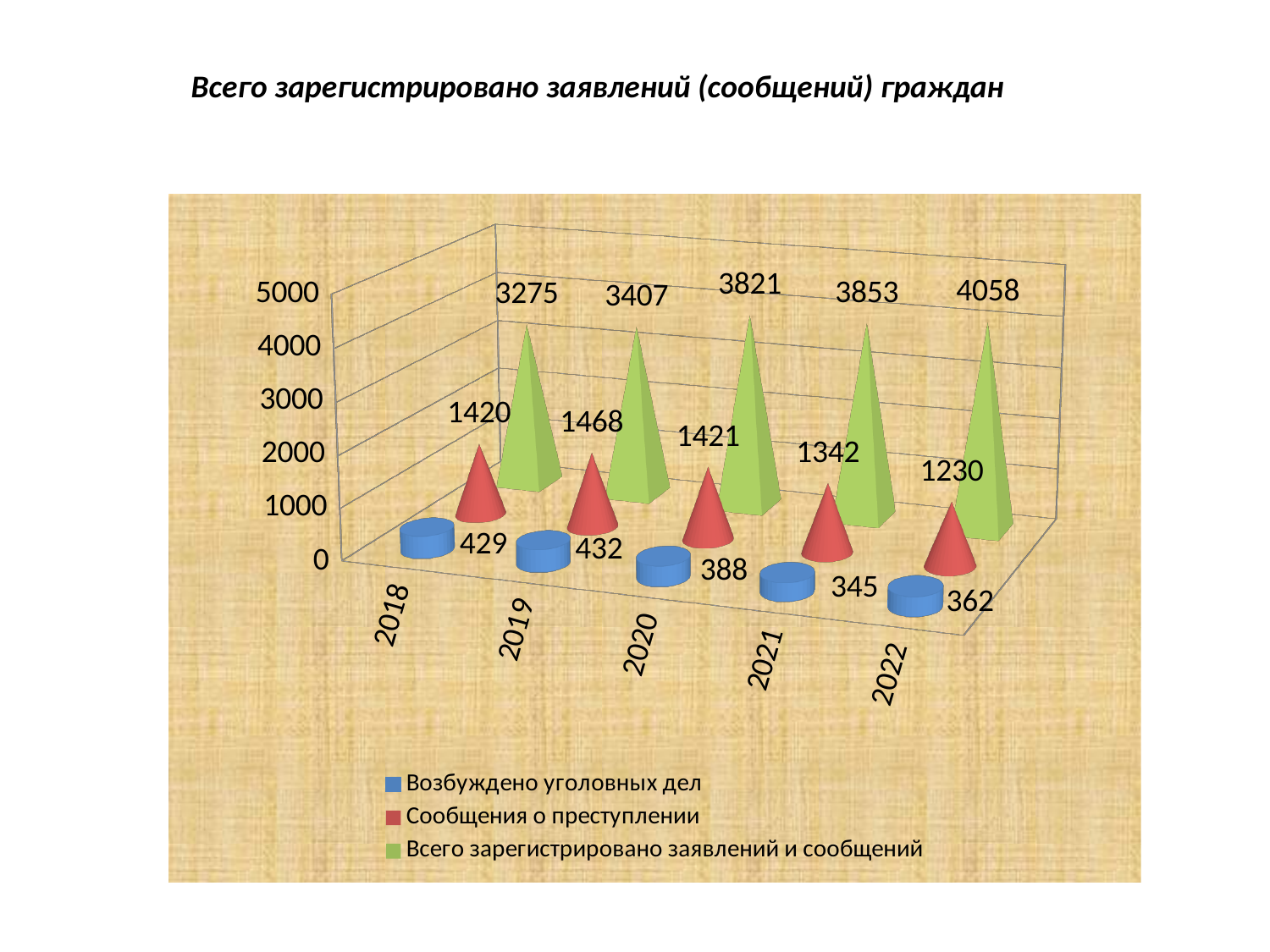
What is the value for 'Всего зарегистрировано заявлений и сообщений' in 2022? 4058 Does 'Всего зарегистрировано заявлений и сообщений' rise or fall from 2018 to 2022? rise What kind of chart is shown on the slide? bar chart In which year is 'Возбуждено уголовных дел' lowest? 2021 What is the difference between 'Всего зарегистрировано заявлений и сообщений' in 2022 and in 2018? 783 Is the value for 'Всего зарегистрировано заявлений и сообщений' in 2020 greater or less than 3000? greater How many series does the legend list? 3 How many years are shown on the x axis? 5 In which year is 'Всего зарегистрировано заявлений и сообщений' highest? 2022 What is the value for 'Возбуждено уголовных дел' in 2020? 388 What is the value for 'Сообщения о преступлении' in 2019? 1468 Which is larger: 'Сообщения о преступлении' in 2018 or in 2022? 2018